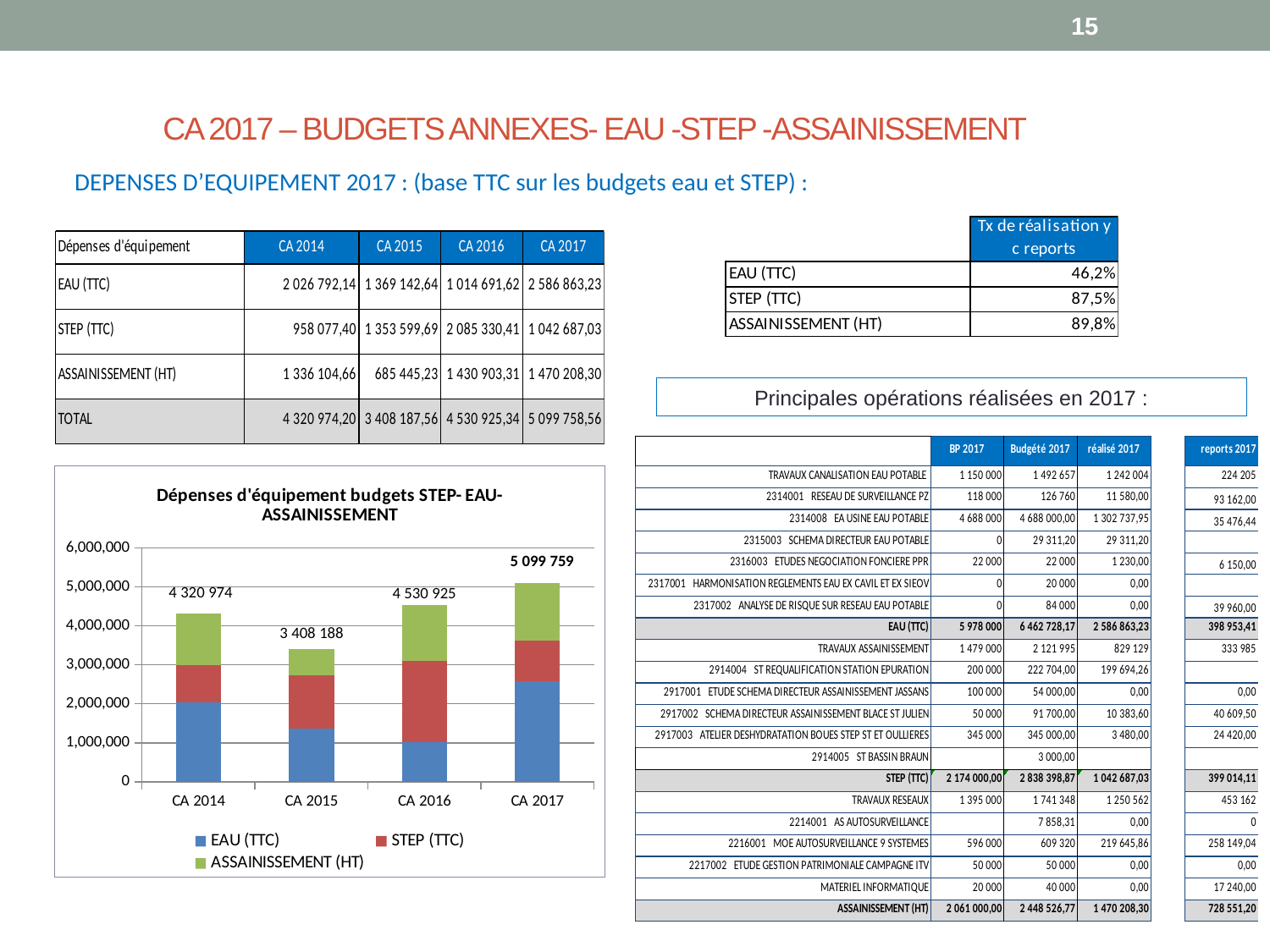
How many series does the chart legend list? 3 What is the total value labelled above the CA 2015 bar? 3 408 188 Which category has the highest total bar? CA 2017 How many categories are shown on the x axis of the chart? 4 What is the difference between the total for CA 2016 and the total for CA 2015? 1 122 737 Which total is larger, CA 2016 or CA 2014? CA 2016 Which category has the lowest total bar? CA 2015 Is the EAU (TTC) value for CA 2016 greater or less than 2,000,000? less What is the total value labelled above the CA 2017 bar? 5 099 759 What is the difference between the total for CA 2017 and the total for CA 2014? 778 785 What kind of chart is shown on the slide? bar chart Is the EAU (TTC) value for CA 2017 greater or less than 2,000,000? greater